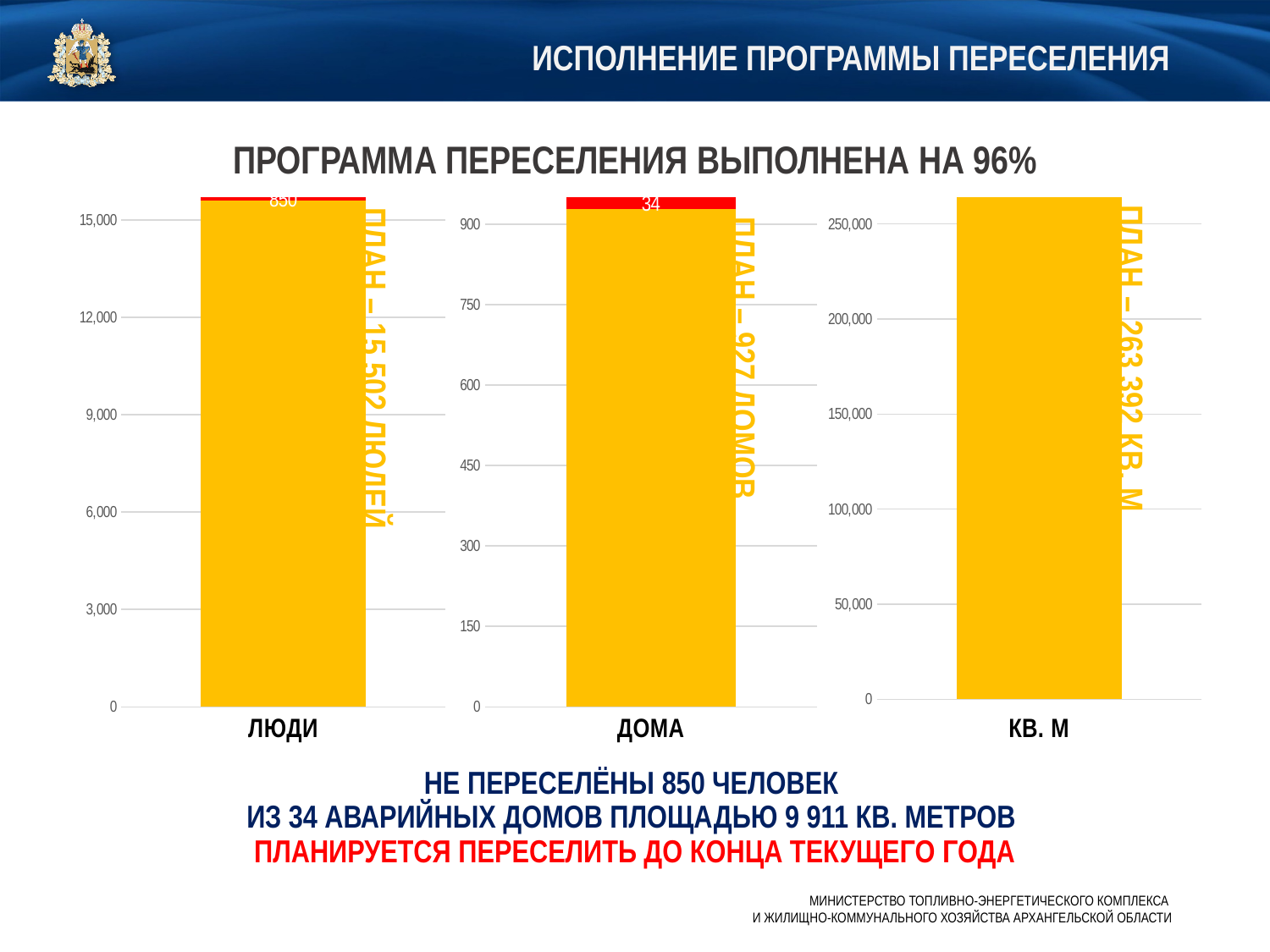
On the КВ. М chart, is the top of the bar greater or less than 250,000? greater On the ЛЮДИ chart, is the top of the stacked bar greater or less than 15,000? greater On the ДОМА chart, what is the difference between the plan of 927 houses and the 34 shown on the red segment? 893 On the ЛЮДИ chart, is the top of the yellow segment greater or less than 12,000? greater How many charts are shown on the slide? 3 On the ЛЮДИ chart, what plan value is written in the vertical label next to the bar? ПЛАН – 15 502 ЛЮДЕЙ What kind of chart is used for the ЛЮДИ, ДОМА and КВ. М figures? bar chart On the ЛЮДИ chart, what value is printed on the red segment at the top of the bar? 850 On the КВ. М chart, what plan value is written in the vertical label next to the bar? ПЛАН – 263 392 КВ. М On the ДОМА chart, what value is printed on the red segment at the top of the bar? 34 On the ЛЮДИ chart, what is the difference between the plan of 15 502 people and the 850 shown on the red segment? 14 652